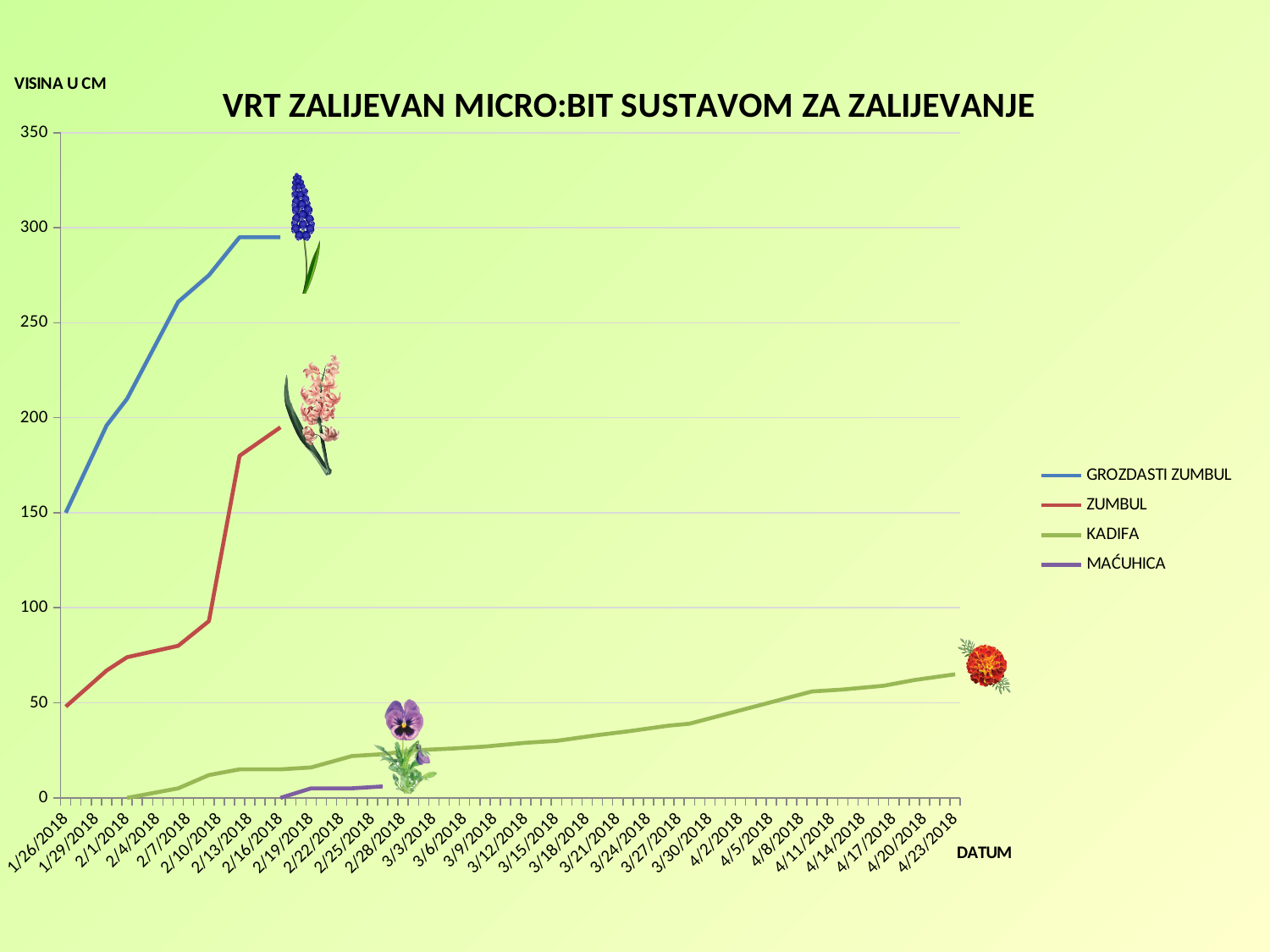
Which series stays lowest on the chart? MAĆUHICA What is the label of the vertical axis? VISINA U CM Does the KADIFA line rise or fall from 2/1/2018 to 4/23/2018? rise Is the value for GROZDASTI ZUMBUL on 2/13/2018 greater or less than 250? greater On 2/13/2018, which is larger: GROZDASTI ZUMBUL or ZUMBUL? GROZDASTI ZUMBUL Is the highest value for MAĆUHICA greater or less than 50? less Which series reaches the highest value on the chart? GROZDASTI ZUMBUL How many series does the legend list? 4 What kind of chart is shown on the slide? line chart Is the value for KADIFA on 4/23/2018 greater or less than 50? greater What is the title of the chart? VRT ZALIJEVAN MICRO:BIT SUSTAVOM ZA ZALIJEVANJE